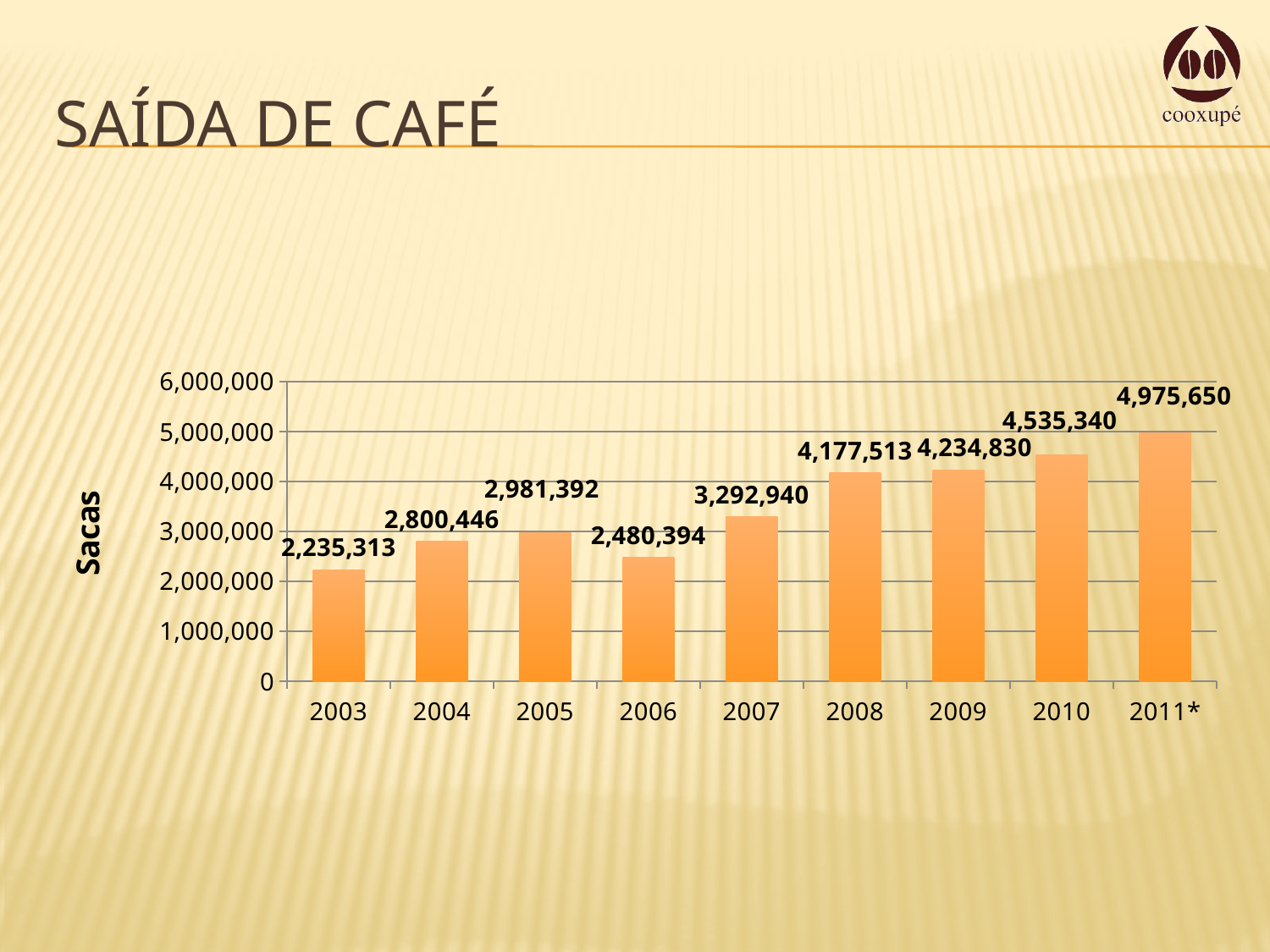
Is the value for 2007 greater or less than 3,000,000? greater What is the difference between the values for 2005 and 2006? 500,998 What kind of chart is shown on the slide? bar chart What is the label of the y axis? Sacas What is the value for 2003? 2,235,313 What is the value for 2007? 3,292,940 Which year has the lowest value? 2003 Which is larger, the value for 2006 or the value for 2007? 2007 What is the difference between the values for 2011* and 2003? 2,740,337 Which year has the highest value? 2011* What is the value for 2011*? 4,975,650 How many years are shown on the x axis? 9